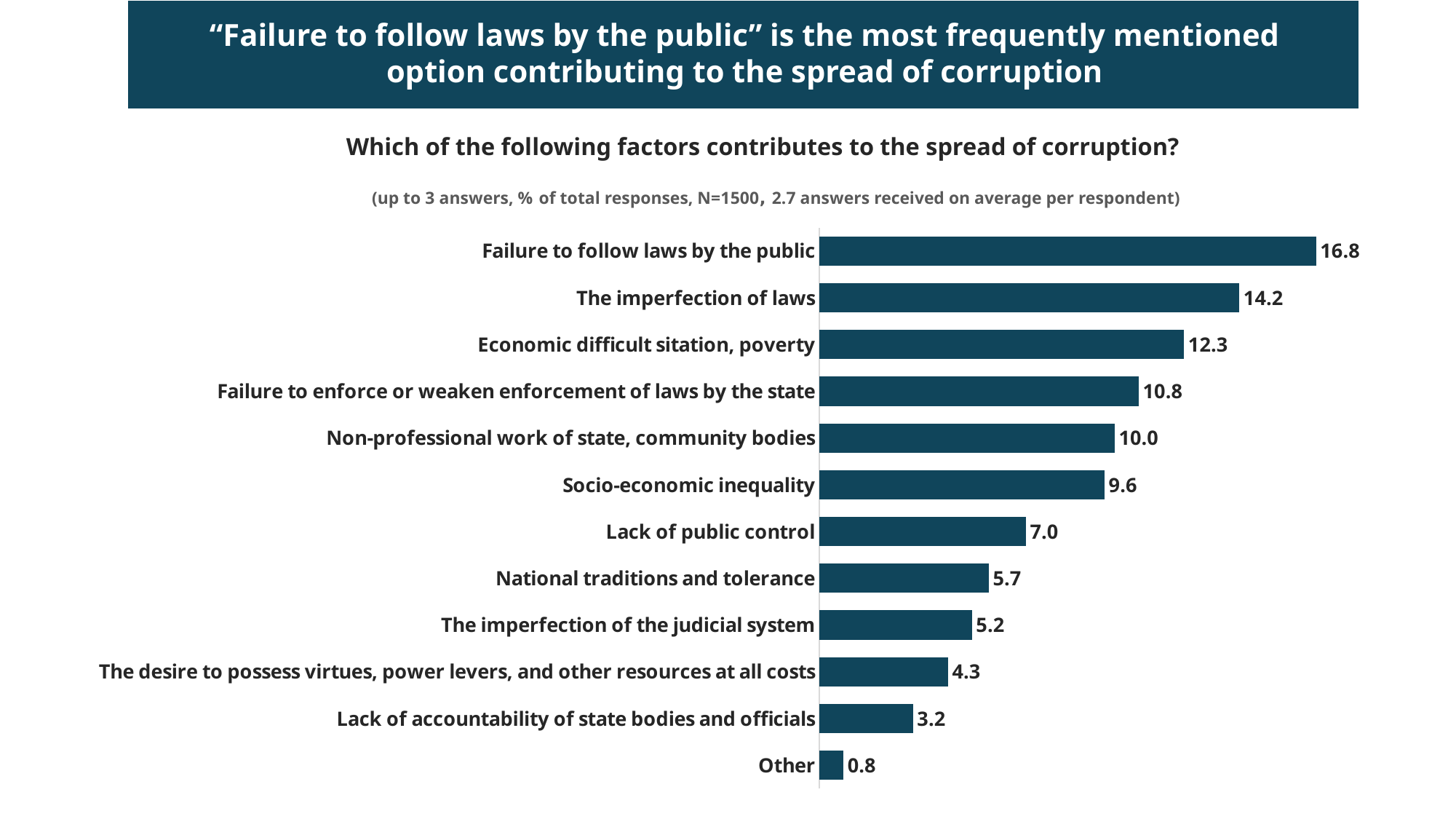
How many categories are shown in the chart? 12 Which category has the lowest value? Other What is the value for "Failure to follow laws by the public"? 16.8 What is the value for "Socio-economic inequality"? 9.6 What question is the chart based on, as stated in its title? Which of the following factors contributes to the spread of corruption? What is the difference between the values for "The imperfection of laws" and "Economic difficult sitation, poverty"? 1.9 Which category has the highest value? Failure to follow laws by the public What is the value for "The imperfection of the judicial system"? 5.2 What is the value for "Lack of accountability of state bodies and officials"? 3.2 Which is larger: the value for "Non-professional work of state, community bodies" or the value for "Lack of public control"? Non-professional work of state, community bodies What is the difference between the values for "Lack of public control" and "National traditions and tolerance"? 1.3 What kind of chart is shown on the slide? Bar chart